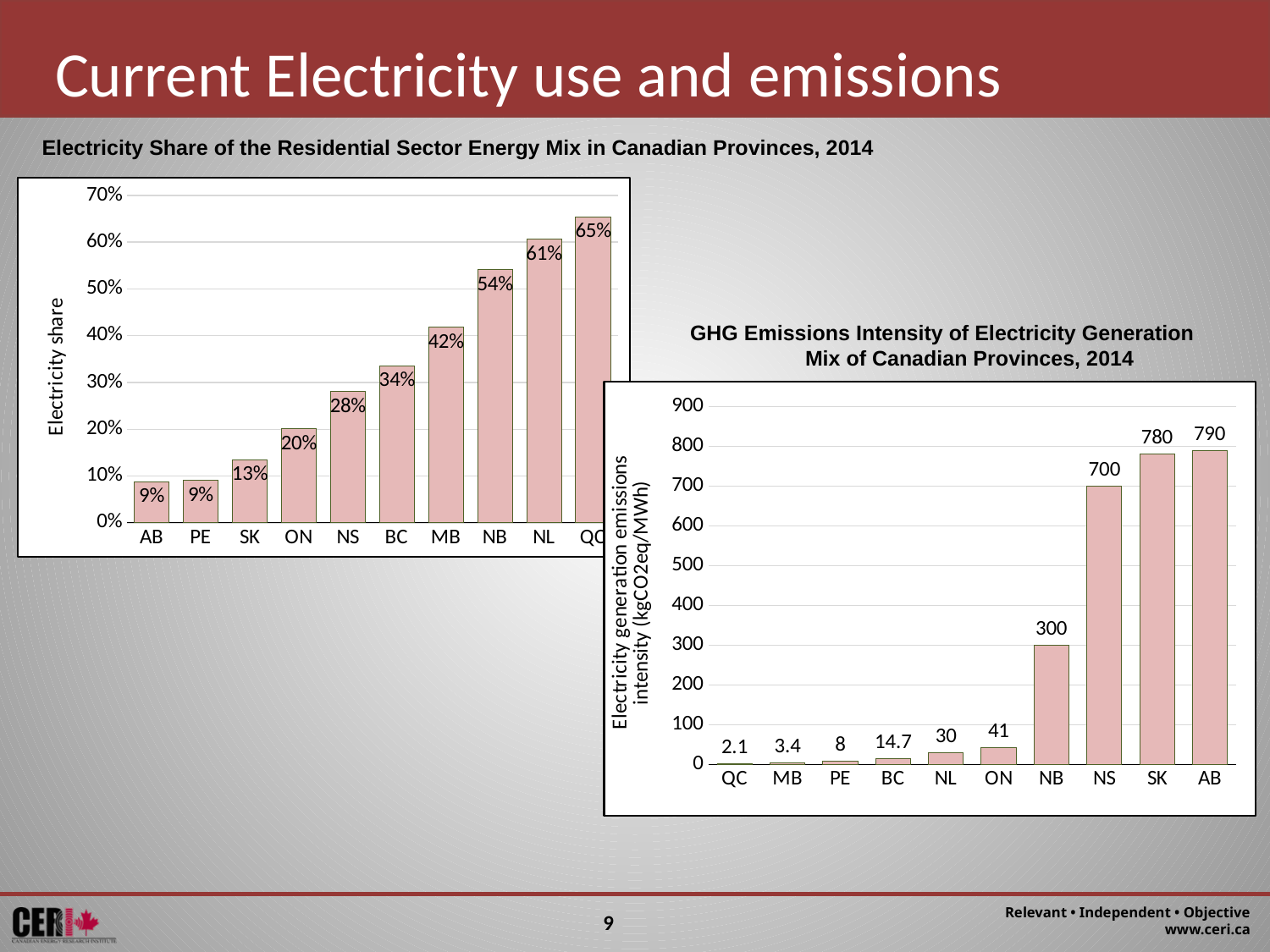
In the 'GHG Emissions Intensity of Electricity Generation Mix of Canadian Provinces, 2014' chart, which is larger, the value for ON or the value for NL? ON In the 'Electricity Share of the Residential Sector Energy Mix in Canadian Provinces, 2014' chart, what is the electricity share for MB? 42% In the 'Electricity Share of the Residential Sector Energy Mix in Canadian Provinces, 2014' chart, do the values rise or fall from left to right along the x axis? rise In the 'Electricity Share of the Residential Sector Energy Mix in Canadian Provinces, 2014' chart, how many provinces are shown? 10 In the 'Electricity Share of the Residential Sector Energy Mix in Canadian Provinces, 2014' chart, which province has the highest electricity share? QC In the 'GHG Emissions Intensity of Electricity Generation Mix of Canadian Provinces, 2014' chart, what is the value for NB? 300 What kind of chart is the 'GHG Emissions Intensity of Electricity Generation Mix of Canadian Provinces, 2014' chart? bar chart In the 'GHG Emissions Intensity of Electricity Generation Mix of Canadian Provinces, 2014' chart, which province has the highest emissions intensity? AB In the 'GHG Emissions Intensity of Electricity Generation Mix of Canadian Provinces, 2014' chart, what is the difference between the values for SK and NS? 80 What is the y-axis label of the 'GHG Emissions Intensity of Electricity Generation Mix of Canadian Provinces, 2014' chart? Electricity generation emissions intensity (kgCO2eq/MWh) In the 'GHG Emissions Intensity of Electricity Generation Mix of Canadian Provinces, 2014' chart, which province has the lowest emissions intensity? QC In the 'Electricity Share of the Residential Sector Energy Mix in Canadian Provinces, 2014' chart, what is the difference between the electricity share of NL and that of NB? 7%